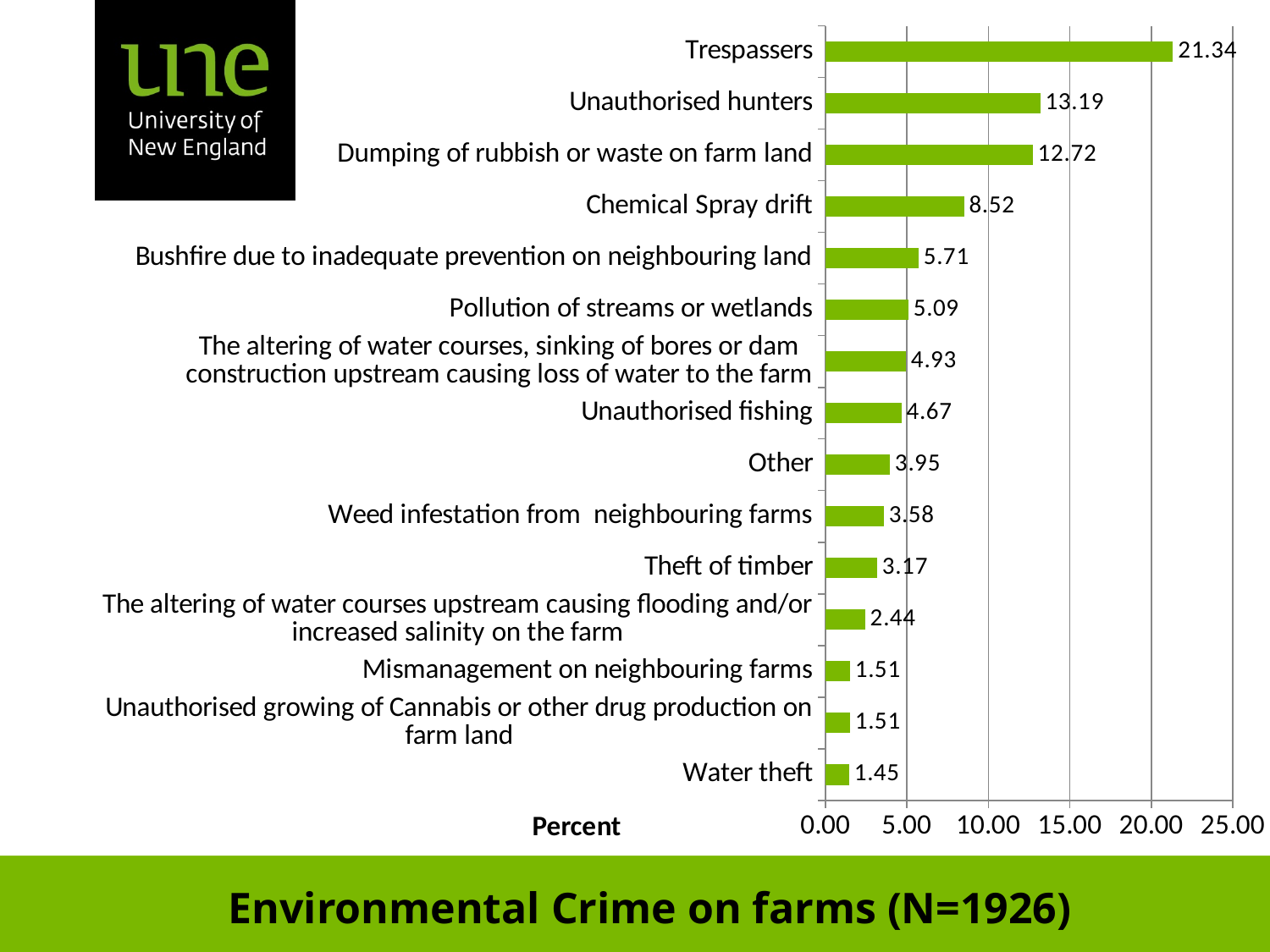
What is the label on the horizontal axis of the chart? Percent What is the difference between the values for Unauthorised hunters and Dumping of rubbish or waste on farm land? 0.47 How many categories are shown in the chart? 15 What is the difference between the values for Trespassers and Unauthorised hunters? 8.15 Is the value for Chemical Spray drift greater or less than 10.00? less What is the value for Trespassers? 21.34 What is the value for Theft of timber? 3.17 What kind of chart is shown on the slide? bar chart Which category has the highest value? Trespassers Which is larger, the value for Pollution of streams or wetlands or the value for Unauthorised fishing? Pollution of streams or wetlands Which category has the lowest value? Water theft What is the value for Chemical Spray drift? 8.52